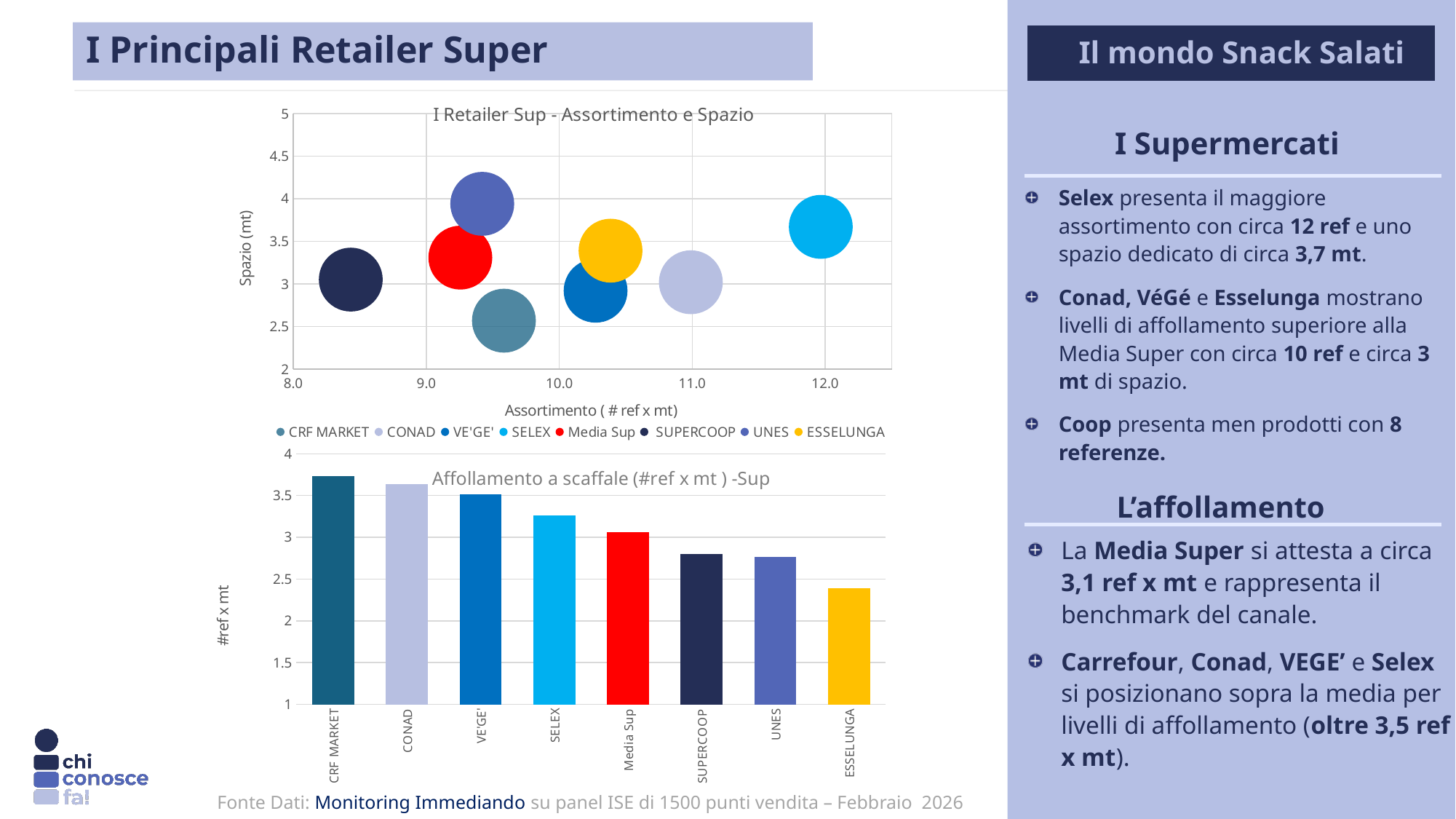
In the chart 'I Retailer Sup - Assortimento e Spazio', is the Assortimento value for SUPERCOOP greater or less than 9.0? less In the bar chart 'Affollamento a scaffale (#ref x mt ) -Sup', which retailer has the highest value? CRF MARKET In the chart 'I Retailer Sup - Assortimento e Spazio', is the Spazio (mt) value for UNES greater or less than 3.5? greater In the chart 'I Retailer Sup - Assortimento e Spazio', which retailer has the highest Assortimento (x-axis) value? SELEX In the bar chart 'Affollamento a scaffale (#ref x mt ) -Sup', is the value for ESSELUNGA greater or less than 2.5? less How many series does the legend of the chart 'I Retailer Sup - Assortimento e Spazio' list? 8 How many retailers are shown in the bar chart 'Affollamento a scaffale (#ref x mt ) -Sup'? 7 In the bar chart 'Affollamento a scaffale (#ref x mt ) -Sup', which is larger, the value for CONAD or the value for Media Sup? CONAD In the bar chart 'Affollamento a scaffale (#ref x mt ) -Sup', which retailer has the lowest value? ESSELUNGA What kind of chart is 'Affollamento a scaffale (#ref x mt ) -Sup'? bar chart